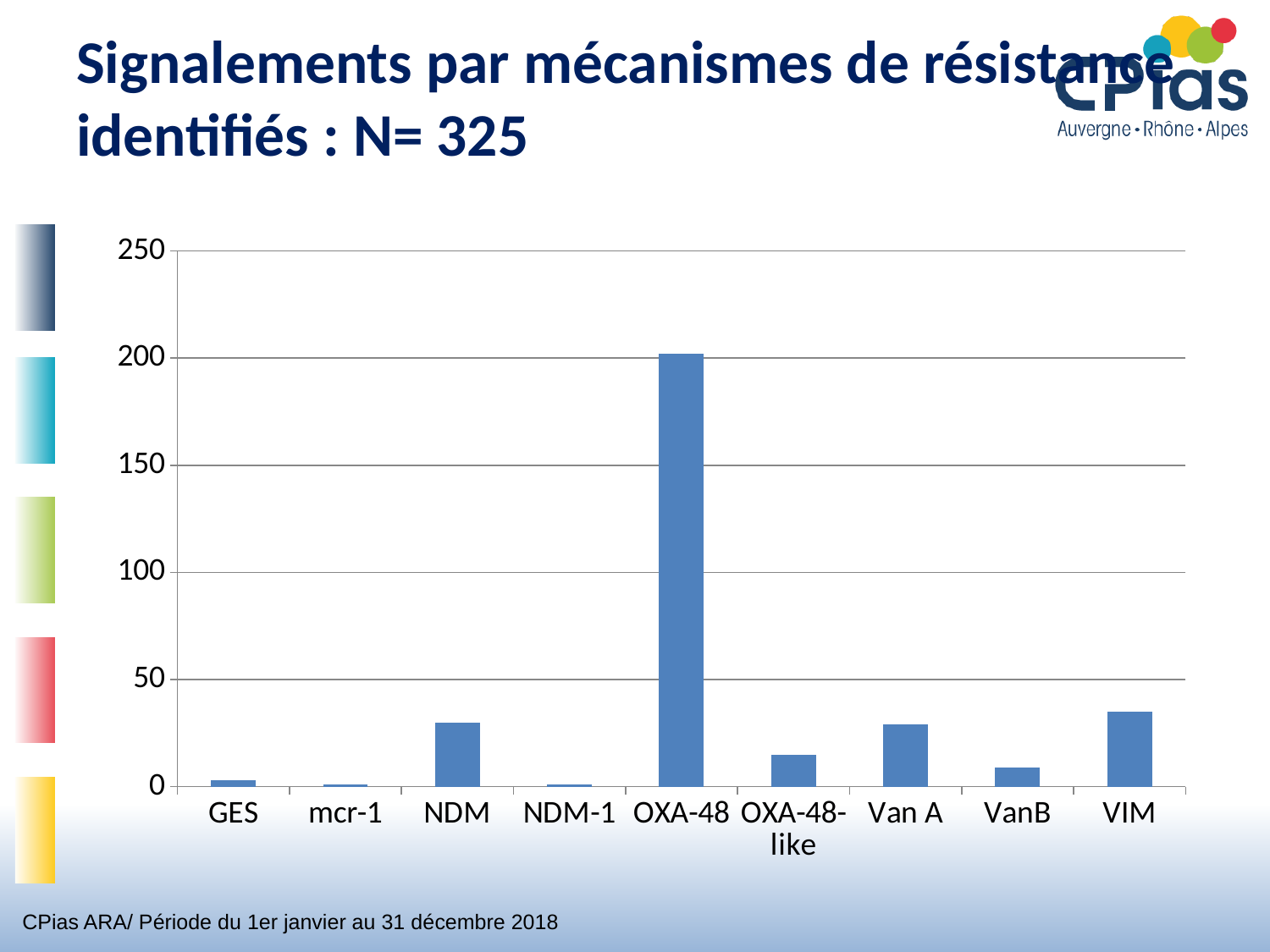
Is the value for VIM greater or less than 50? less Which category has the highest value in the chart? OXA-48 Which is larger, the value for VIM or the value for VanB? VIM What kind of chart is shown on the slide? bar chart Is the value for NDM greater or less than 50? less Is the value for OXA-48 greater or less than 250? less Which is larger, the value for OXA-48 or the value for Van A? OXA-48 Which is larger, the value for NDM or the value for GES? NDM How many categories are shown on the x axis of the chart? 9 What is the total N stated in the slide title? 325